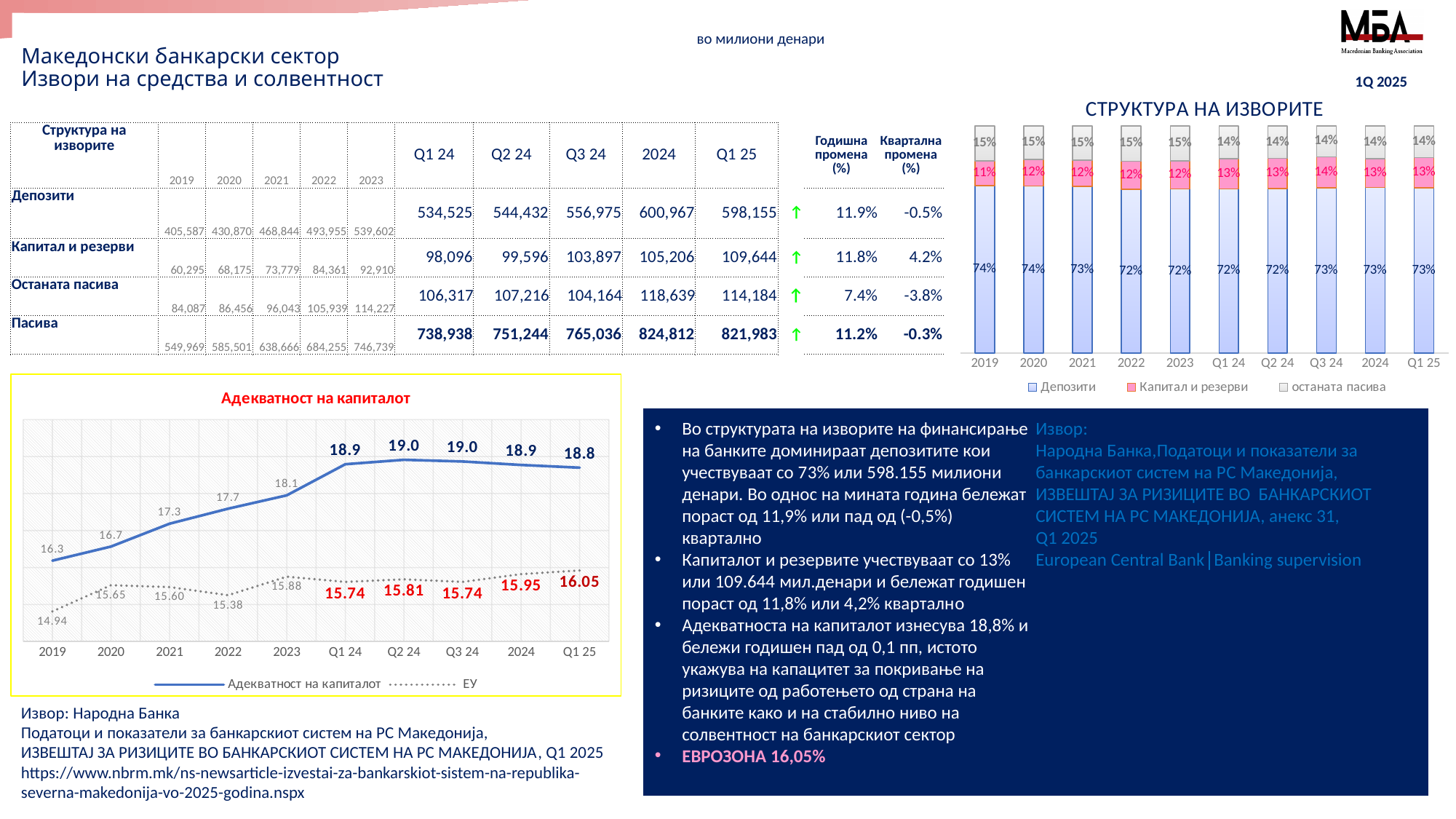
How many periods are shown on the x axis of the СТРУКТУРА НА ИЗВОРИТЕ chart? 10 In the Адекватност на капиталот chart, does the Адекватност на капиталот series rise or fall from 2019 to 2023? rise In the Адекватност на капиталот chart, what is the value of Адекватност на капиталот for 2019? 16.3 In the СТРУКТУРА НА ИЗВОРИТЕ chart, what is the share of Депозити in 2019? 74% In the Адекватност на капиталот chart, what is the difference between Адекватност на капиталот and ЕУ in Q1 25? 2.75 What kind of chart is the Адекватност на капиталот chart? line chart In the Адекватност на капиталот chart, what is the value of the ЕУ series for Q1 25? 16.05 In the СТРУКТУРА НА ИЗВОРИТЕ chart, what is the share of Капитал и резерви in Q3 24? 14% In the Адекватност на капиталот chart, which period has the lowest value for the ЕУ series? 2019 How many series does the legend of the Адекватност на капиталот chart list? 2 How many series does the legend of the СТРУКТУРА НА ИЗВОРИТЕ chart list? 3 In the Адекватност на капиталот chart, which period has the lowest value for Адекватност на капиталот? 2019